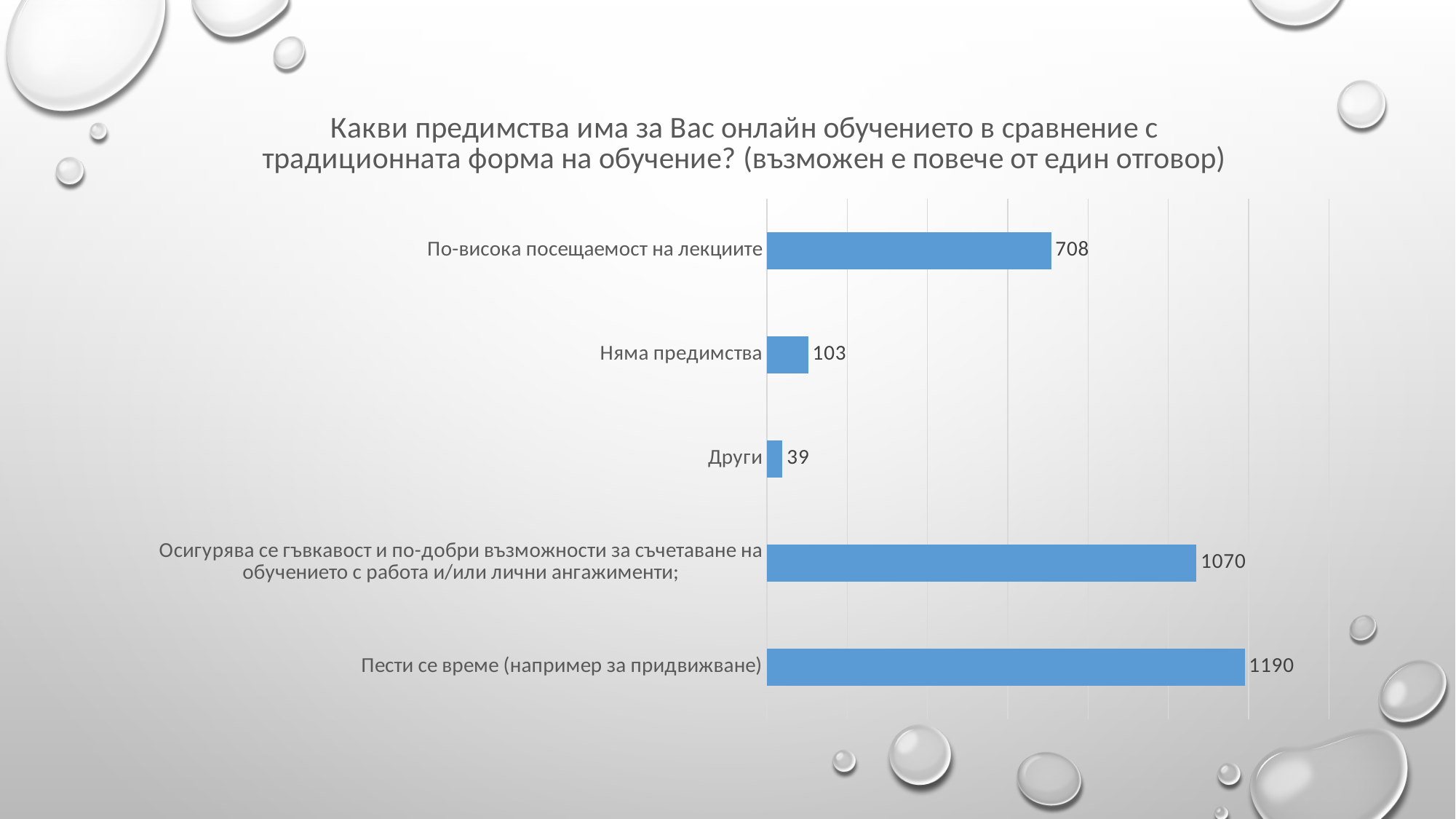
What kind of chart is shown on the slide? Bar chart Which category has the lowest value? Други What colour are the bars in the chart? Blue What is the value for "Други"? 39 What is the difference between the values for "Пести се време (например за придвижване)" and "Осигурява се гъвкавост и по-добри възможности за съчетаване на обучението с работа и/или лични ангажименти;"? 120 What is the value for "По-висока посещаемост на лекциите"? 708 Which category has the highest value? Пести се време (например за придвижване) What is the value for "Пести се време (например за придвижване)"? 1190 Which is larger, the value for "Няма предимства" or the value for "Други"? Няма предимства What is the difference between the values for "По-висока посещаемост на лекциите" and "Няма предимства"? 605 How many categories are shown in the chart? 5 What is the value for "Няма предимства"? 103